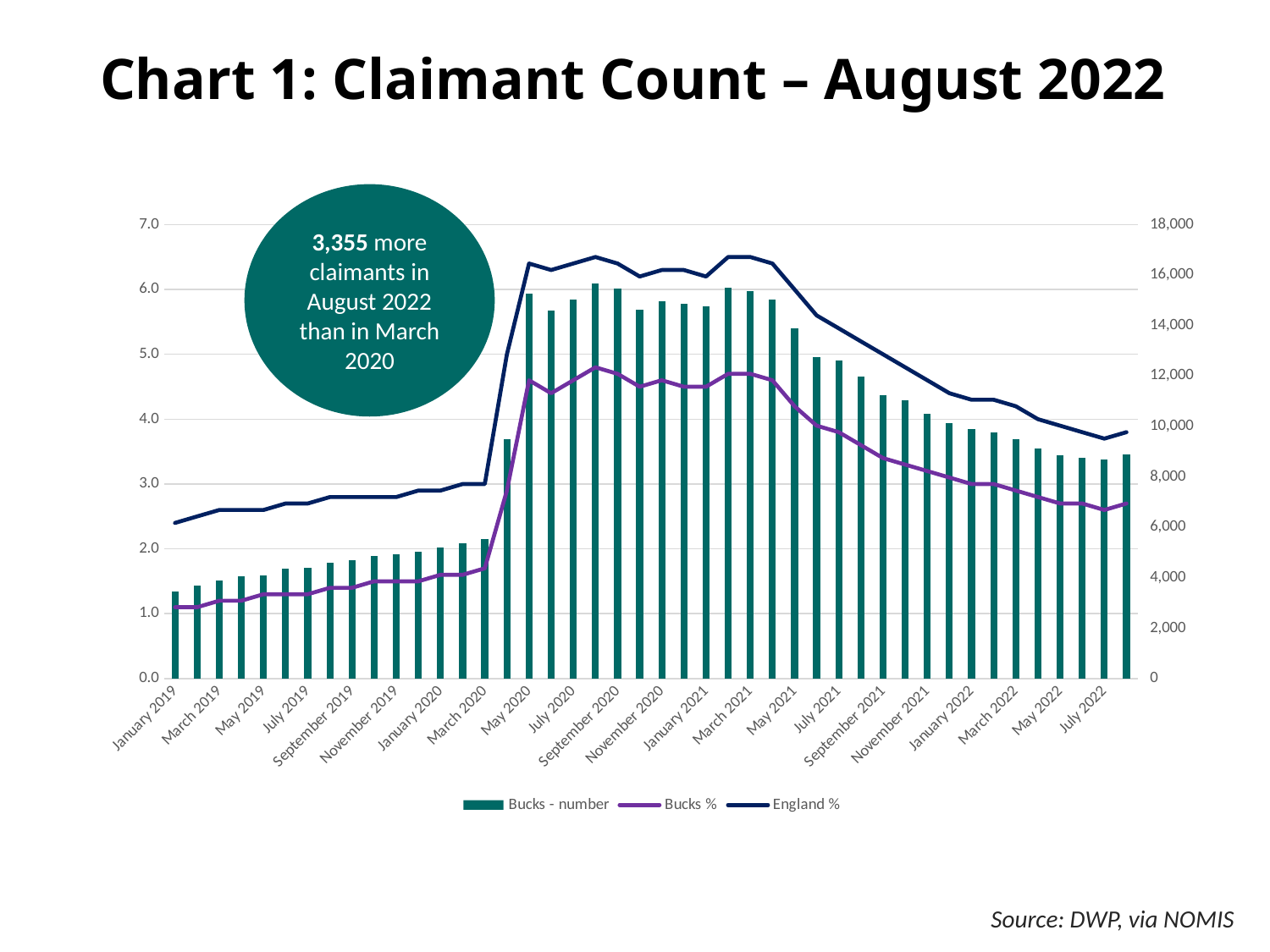
Is the Bucks % value for July 2022 greater or less than 3.0? less What kind of chart is this? Combined bar and line chart Is the England % value for May 2020 greater or less than 6.0? greater How many series does the legend list? 3 According to the callout, how many more claimants were there in August 2022 than in March 2020? 3,355 Which month has the lowest Bucks - number bar? January 2019 Which series is plotted as bars? Bucks - number Is the Bucks % value for May 2020 greater or less than 4.0? greater In January 2021, which is larger: England % or Bucks %? England % Do the Bucks - number bars rise or fall from March 2021 to July 2022? fall